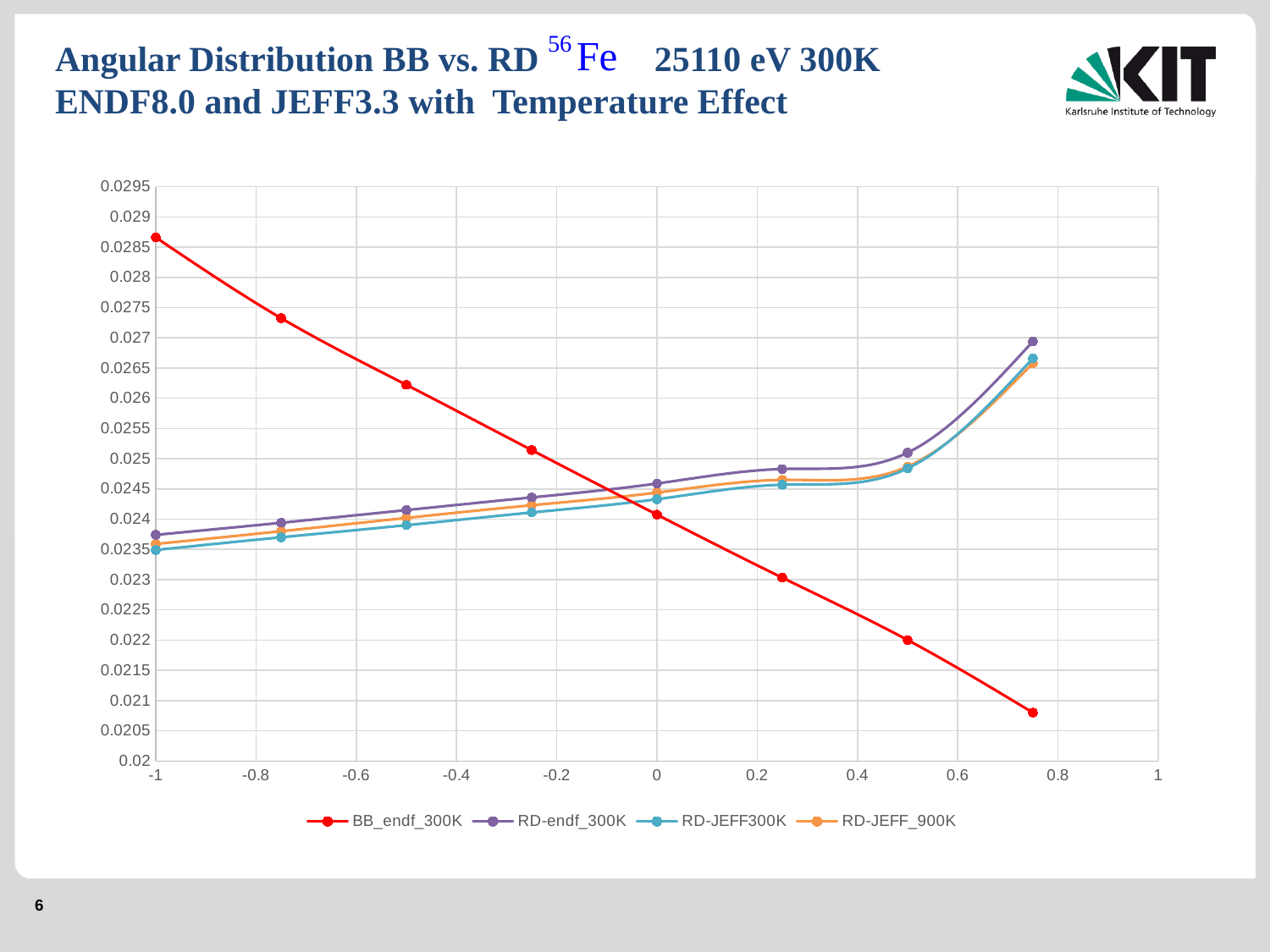
What kind of chart is shown on the slide? line chart Is the value of BB_endf_300K at x = 0.75 greater or less than 0.021? less Which series has the lowest value at x = 0.75? BB_endf_300K What colour is the BB_endf_300K series drawn in? red Does the RD-endf_300K series rise or fall as x increases from -1 to 0.75? rise At x = 0.75, which is larger: BB_endf_300K or RD-JEFF300K? RD-JEFF300K How many series does the legend list? 4 Is the value of BB_endf_300K at x = -1 greater or less than 0.028? greater Does the BB_endf_300K series rise or fall as x increases from -1 to 0.75? fall How many data points are plotted for the BB_endf_300K series? 8 At x = -1, which is larger: BB_endf_300K or RD-endf_300K? BB_endf_300K Is the value of RD-endf_300K at x = 0.75 greater or less than 0.0265? greater